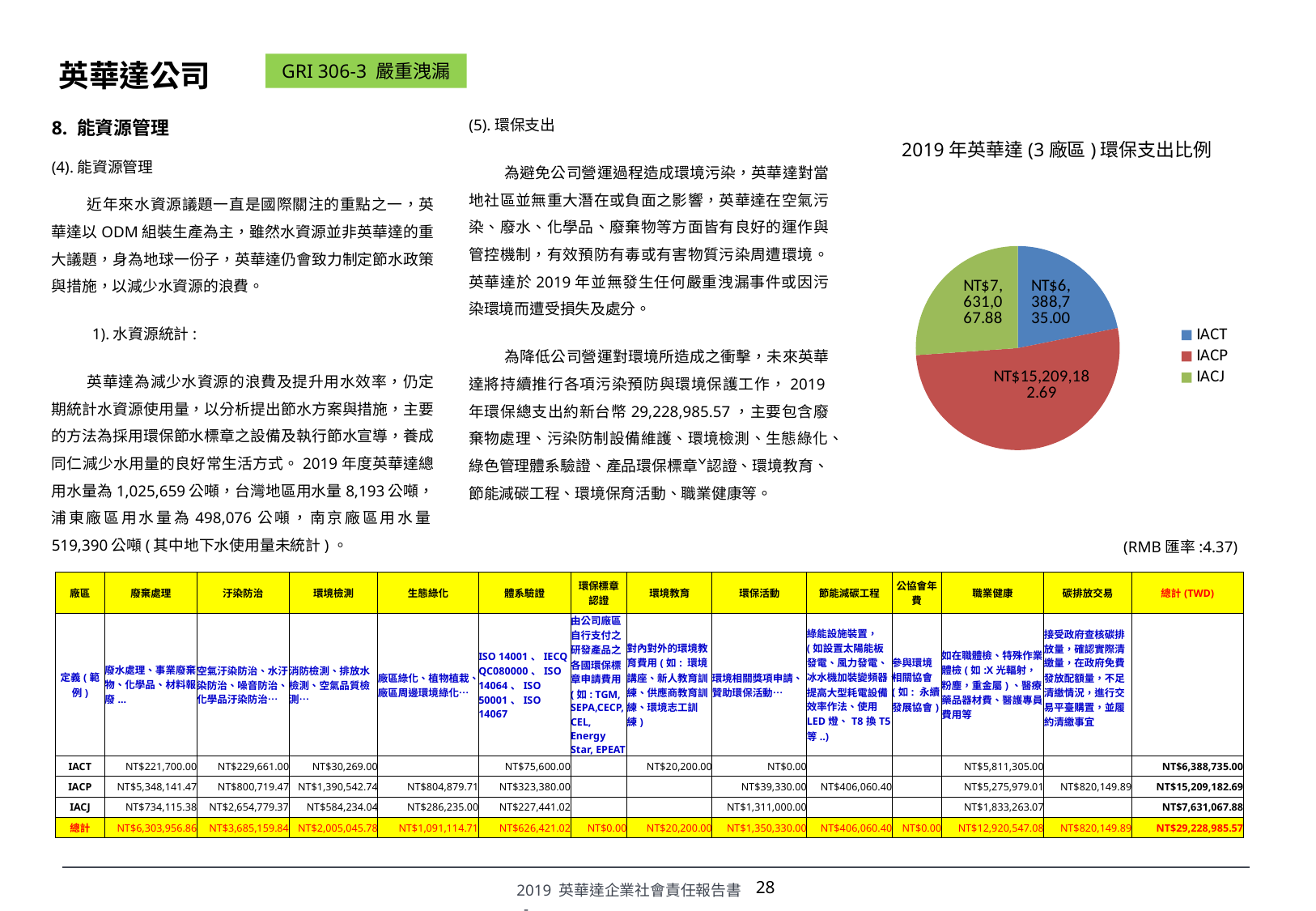
How many slices does the pie chart have? 3 How many entries does the pie chart legend list? 3 What is the value shown for IACT in the pie chart? NT$6,388,735.00 What is the difference between the IACP and IACT values in the pie chart? NT$8,820,447.69 Which colour represents IACP in the pie chart? Red What is the difference between the IACJ and IACT values in the pie chart? NT$1,242,332.88 Which plant has the smallest slice in the pie chart? IACT What type of chart is shown on the slide? Pie chart What is the value shown for IACP in the pie chart? NT$15,209,182.69 Which is larger in the pie chart, IACJ or IACT? IACJ What is the value shown for IACJ in the pie chart? NT$7,631,067.88 Which plant has the largest slice in the pie chart? IACP